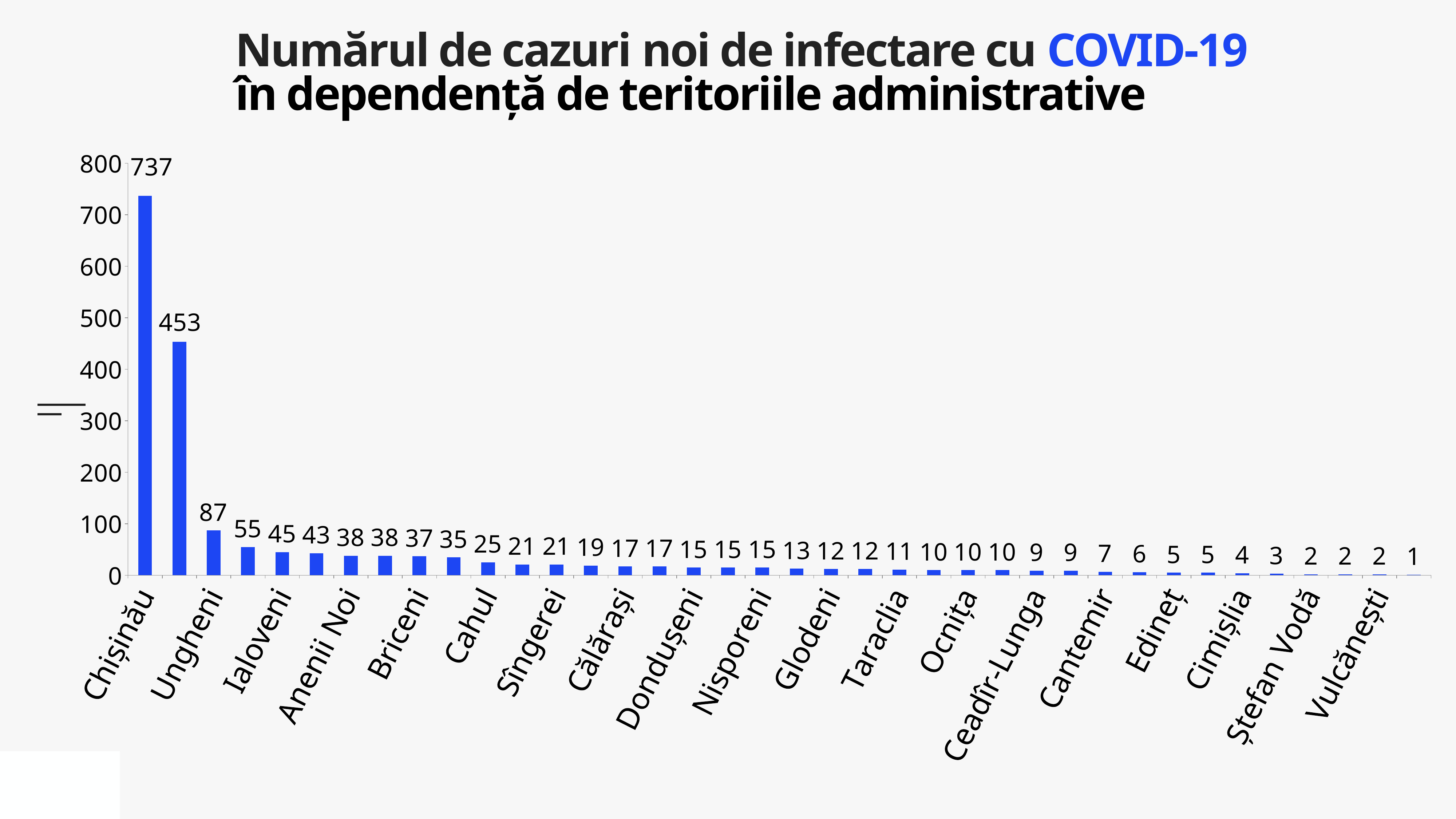
What colour are the bars in the chart? blue What is the smallest value shown in the chart? 1 Which has more new cases, Chișinău or Ungheni? Chișinău Which administrative territory has the highest number of new COVID-19 cases? Chișinău Is the value for Chișinău greater or less than 700? greater What is the second-highest value shown in the chart? 453 What type of chart is shown on the slide? bar chart How many new COVID-19 cases are shown for Chișinău? 737 Is the value for Ialoveni greater or less than 100? less Do the values rise or fall from left to right along the x axis? fall What is the difference between the two highest values in the chart (737 and 453)? 284 How many bars are plotted in the chart? 38